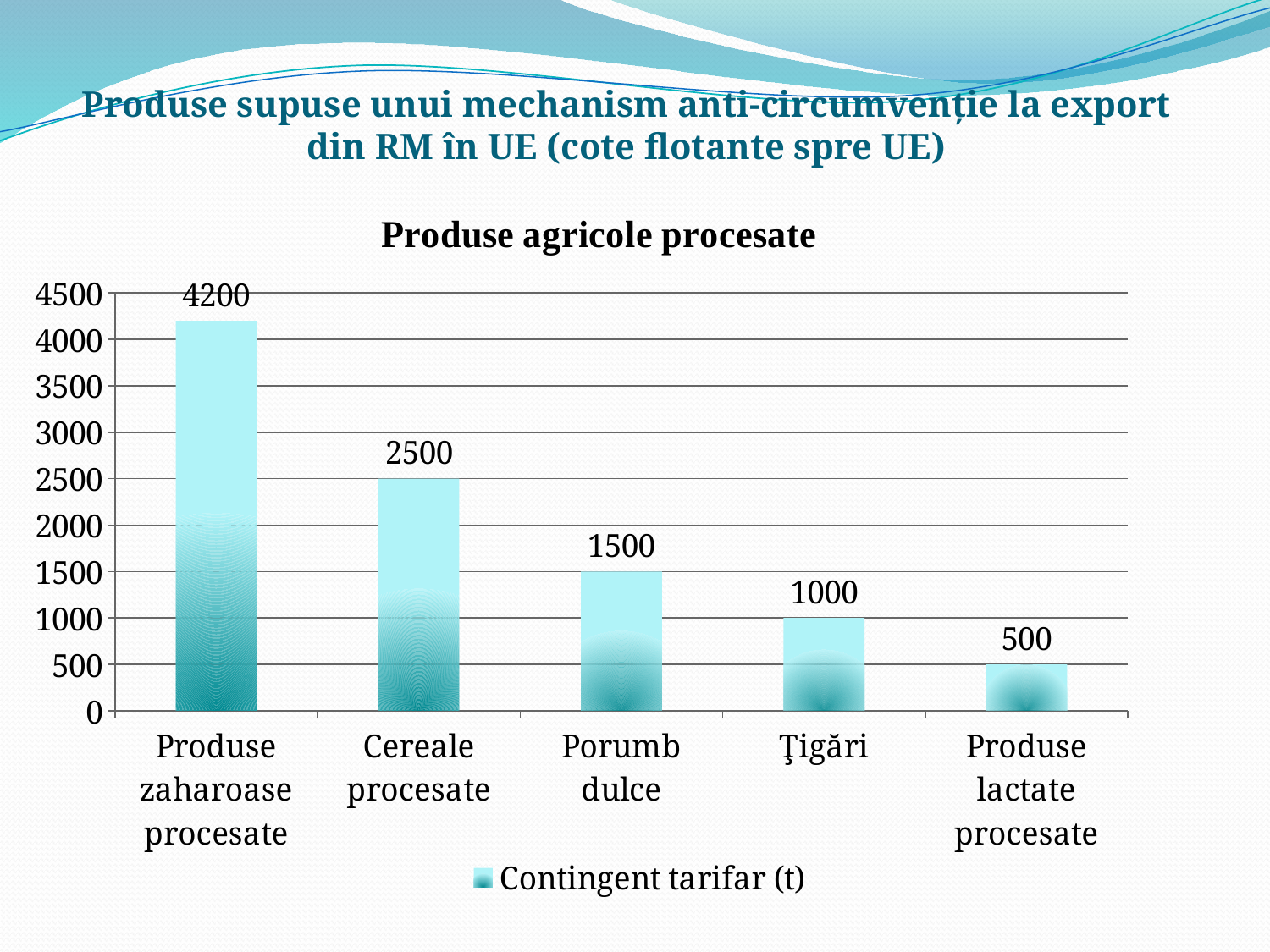
What is the value for Produse lactate procesate? 500 What is the value for Produse zaharoase procesate? 4200 What is the difference between the values for Produse zaharoase procesate and Cereale procesate? 1700 What is the legend entry of the chart? Contingent tarifar (t) Is the value for Cereale procesate greater or less than 2000? greater Which category has the lowest value? Produse lactate procesate What kind of chart is shown? Bar chart What is the value for Porumb dulce? 1500 How many categories are shown on the x axis? 5 Which category has the highest value? Produse zaharoase procesate What is the value for Cereale procesate? 2500 Which is larger, the value for Porumb dulce or the value for Ţigări? Porumb dulce